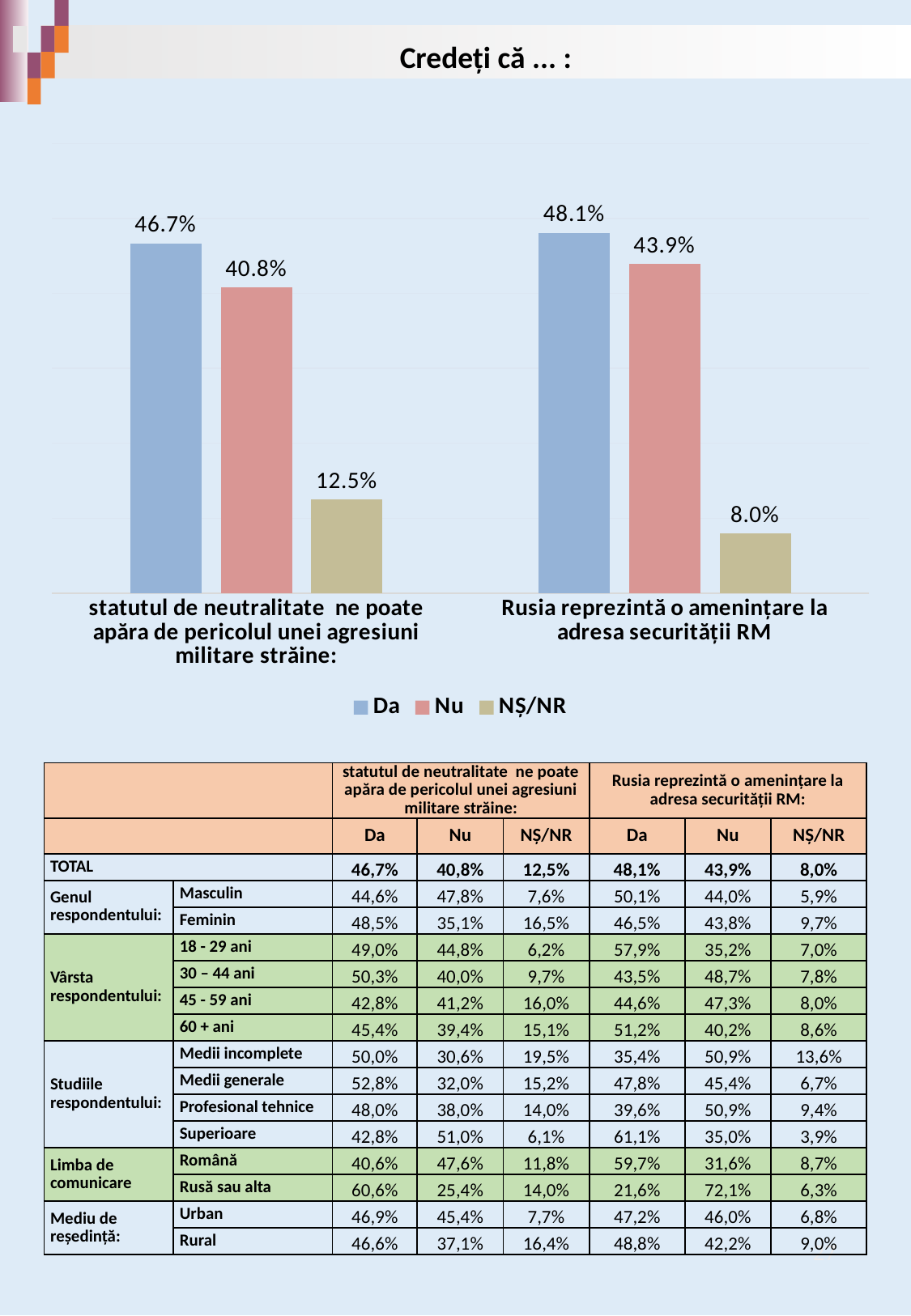
Which response has the lowest value for the statement "statutul de neutralitate ne poate apăra de pericolul unei agresiuni militare străine"? NȘ/NR What kind of chart is shown on the slide? Bar chart Which is larger: the "Da" value for "statutul de neutralitate ne poate apăra de pericolul unei agresiuni militare străine" or the "Da" value for "Rusia reprezintă o amenințare la adresa securității RM"? Rusia reprezintă o amenințare la adresa securității RM Which response has the highest value for the statement "Rusia reprezintă o amenințare la adresa securității RM"? Da How many series does the legend list? 3 What is the value for "Nu" for the statement "Rusia reprezintă o amenințare la adresa securității RM"? 43.9% What is the value for "NȘ/NR" for the statement "statutul de neutralitate ne poate apăra de pericolul unei agresiuni militare străine"? 12.5% What is the difference between the "Da" and "Nu" values for the statement "statutul de neutralitate ne poate apăra de pericolul unei agresiuni militare străine"? 5.9% What is the difference between the "NȘ/NR" values for the two statements? 4.5% What colour are the "Nu" bars in the chart? Red (pink) What is the value for "Da" for the statement "statutul de neutralitate ne poate apăra de pericolul unei agresiuni militare străine"? 46.7% What is the value for "NȘ/NR" for the statement "Rusia reprezintă o amenințare la adresa securității RM"? 8.0%